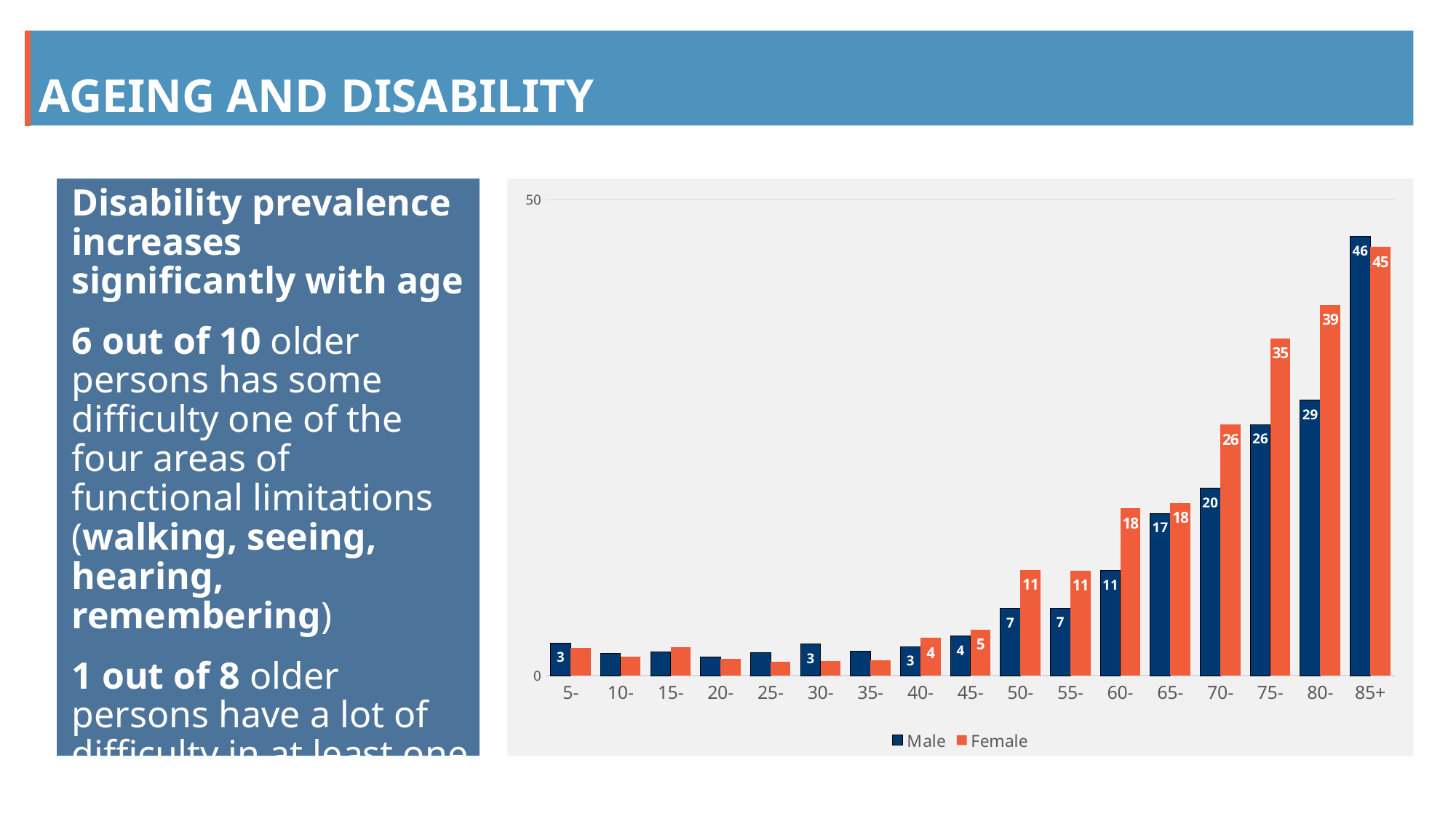
Do the Female values generally rise or fall as age increases from 40- to 85+? Rise What is the Female value for the 60- age group? 18 What is the difference between the Male values for the 85+ and 80- age groups? 17 What is the Female value for the 75- age group? 35 What kind of chart is shown on the slide? Bar chart What is the difference between the Female and Male values for the 80- age group? 10 How many age groups are shown on the x axis? 17 How many series does the legend list? 2 Which is larger for the 75- age group, the Male value or the Female value? Female What is the Male value for the 85+ age group? 46 What is the Male value for the 70- age group? 20 Which age group has the highest Female value? 85+